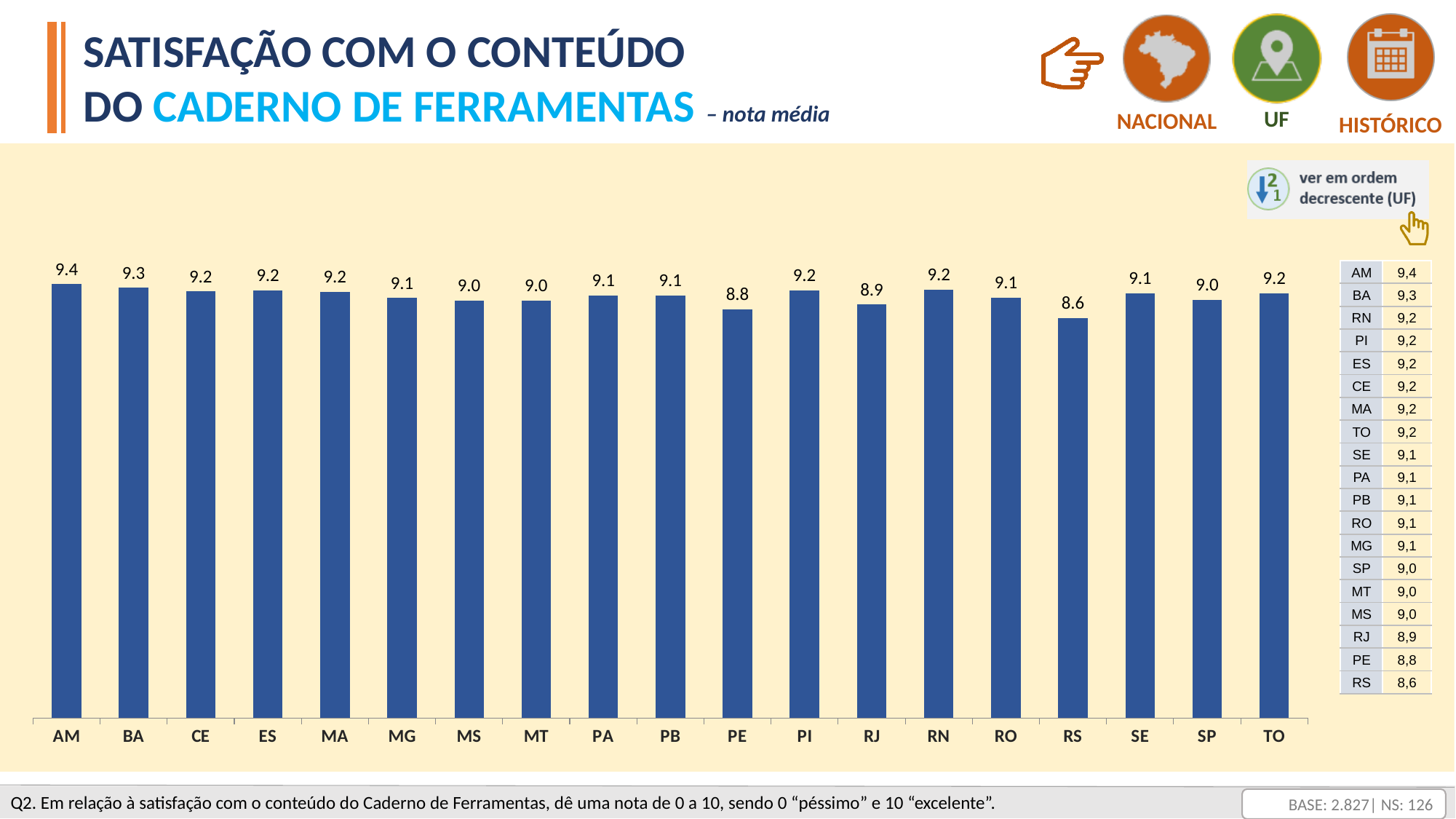
Which has a larger value, PE or RS? PE Which has a larger value, RJ or BA? BA How many categories (UFs) are shown on the x axis of the chart? 19 What is the value for PE? 8.8 What kind of chart is shown on the slide? Bar chart What is the difference between the values for BA and PE? 0.5 Which category has the highest value? AM What is the value for TO? 9.2 Which category has the lowest value? RS What is the value for RJ? 8.9 What is the value for AM? 9.4 What is the difference between the values for AM and RS? 0.8